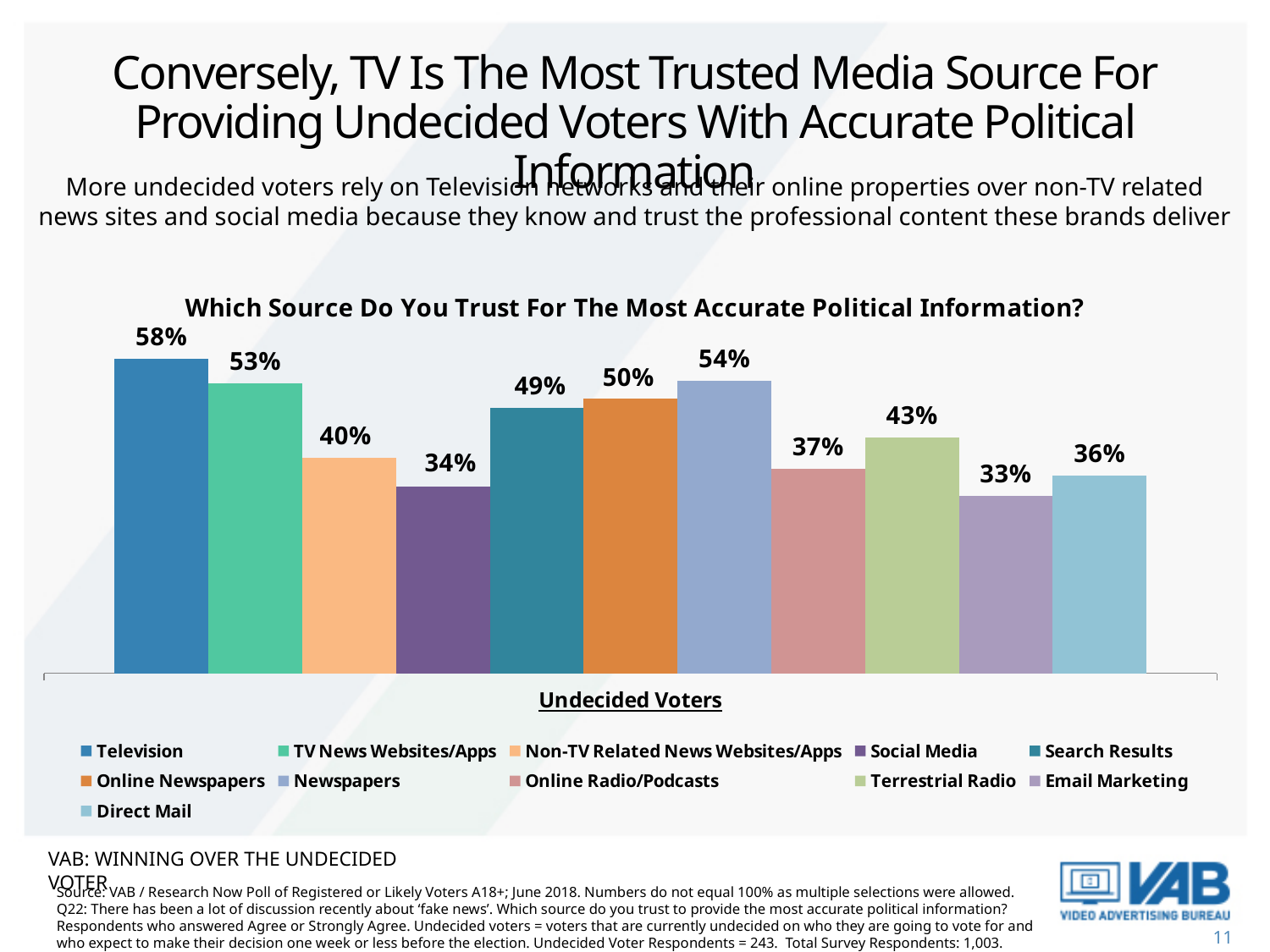
Which has a larger value, Direct Mail or Online Radio/Podcasts? Online Radio/Podcasts What is the difference between the values for Television and TV News Websites/Apps? 5% What is the value shown for Newspapers? 54% What is the value shown for Terrestrial Radio? 43% How many series does the legend list? 11 Which has a larger value, Search Results or Non-TV Related News Websites/Apps? Search Results What is the value shown for Social Media? 34% What percentage of undecided voters trust Television for the most accurate political information? 58% Which source has the lowest value in the chart? Email Marketing What type of chart is shown on the slide? Bar chart Which source has the highest value in the chart? Television What is the difference between the values for Newspapers and Online Newspapers? 4%